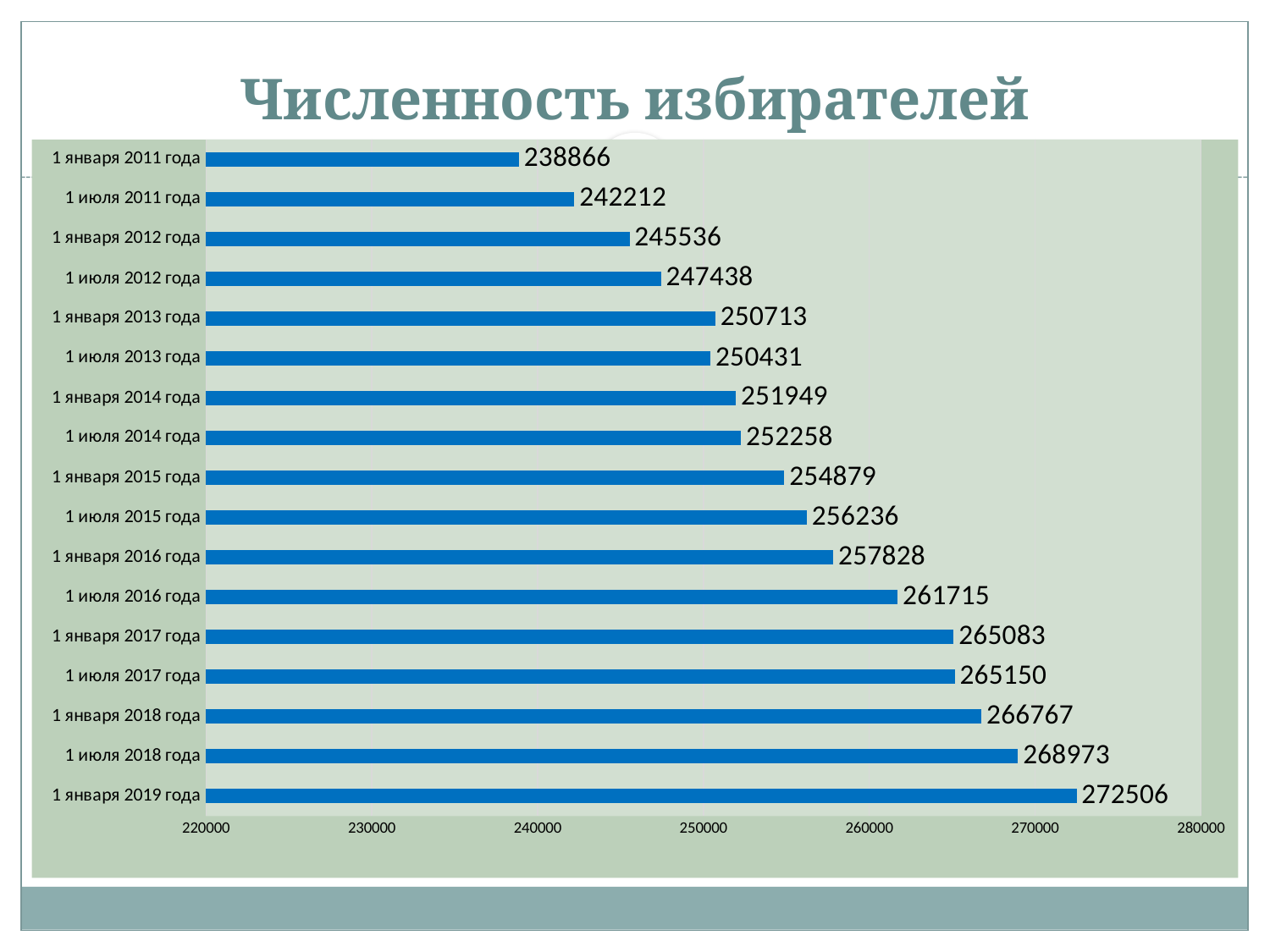
What is the difference between the values for 1 июля 2018 года and 1 января 2018 года? 2206 Is the value for 1 июля 2015 года greater or less than 250000? greater What is the difference between the values for 1 января 2019 года and 1 января 2011 года? 33640 What is the value for 1 января 2011 года? 238866 How many categories are shown in the chart? 17 What is the title of the chart? Численность избирателей What is the value for 1 января 2019 года? 272506 What kind of chart is shown on the slide? Bar chart Which category has the highest value? 1 января 2019 года Which is larger, the value for 1 января 2013 года or 1 июля 2013 года? 1 января 2013 года Which category has the lowest value? 1 января 2011 года What is the value for 1 июля 2016 года? 261715